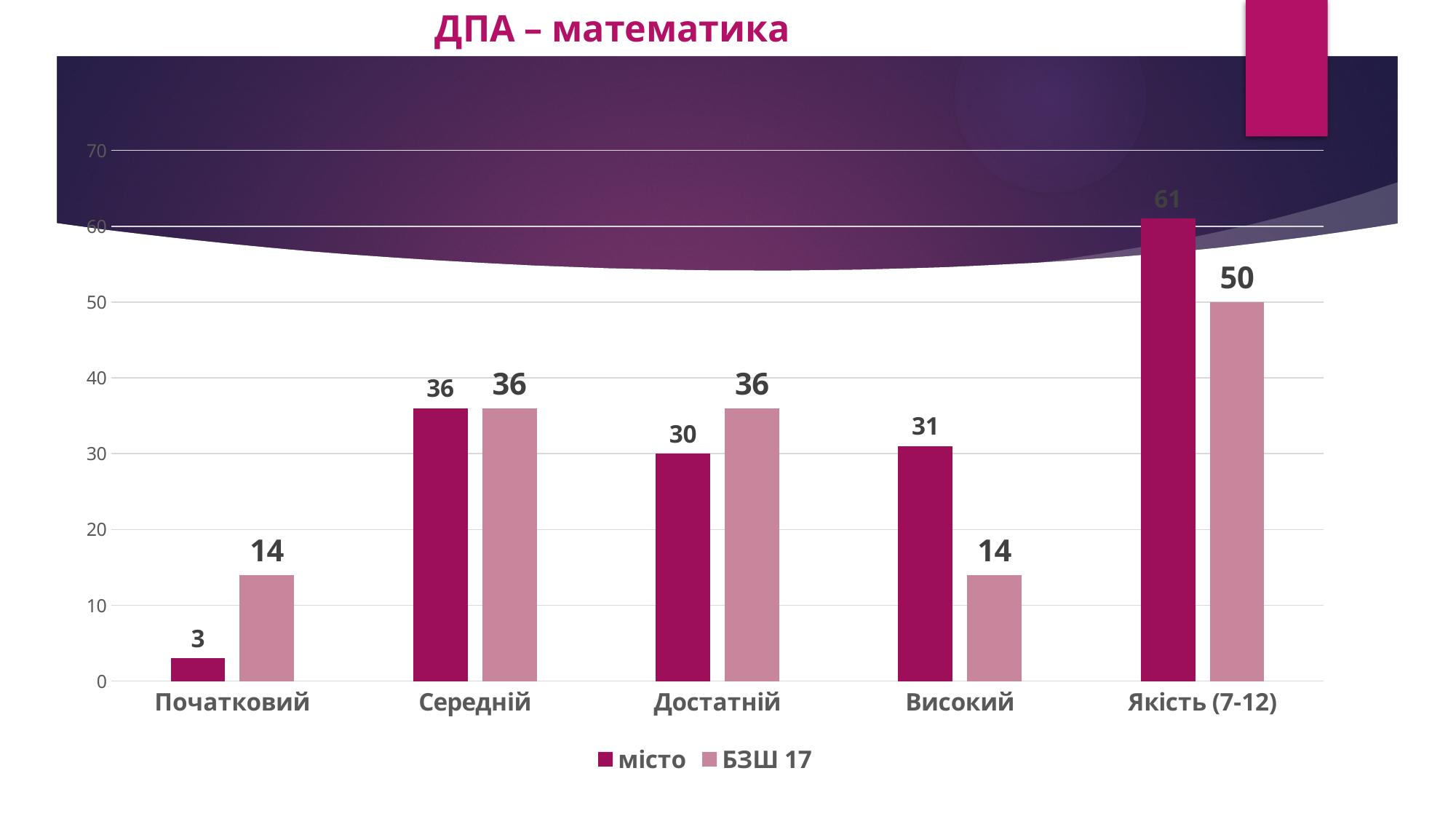
What is the difference between місто and БЗШ 17 in the Високий category? 17 How many categories are shown on the x axis? 5 Which is larger in the Початковий category, місто or БЗШ 17? БЗШ 17 What kind of chart is shown on the slide? Bar chart What is the value for БЗШ 17 in the Високий category? 14 Which category has the highest value for місто? Якість (7-12) What is the value for місто in the Початковий category? 3 Which category has the lowest value for місто? Початковий How many series does the legend list? 2 What is the value for місто in the Якість (7-12) category? 61 What is the value for БЗШ 17 in the Достатній category? 36 What is the title of the chart? ДПА – математика